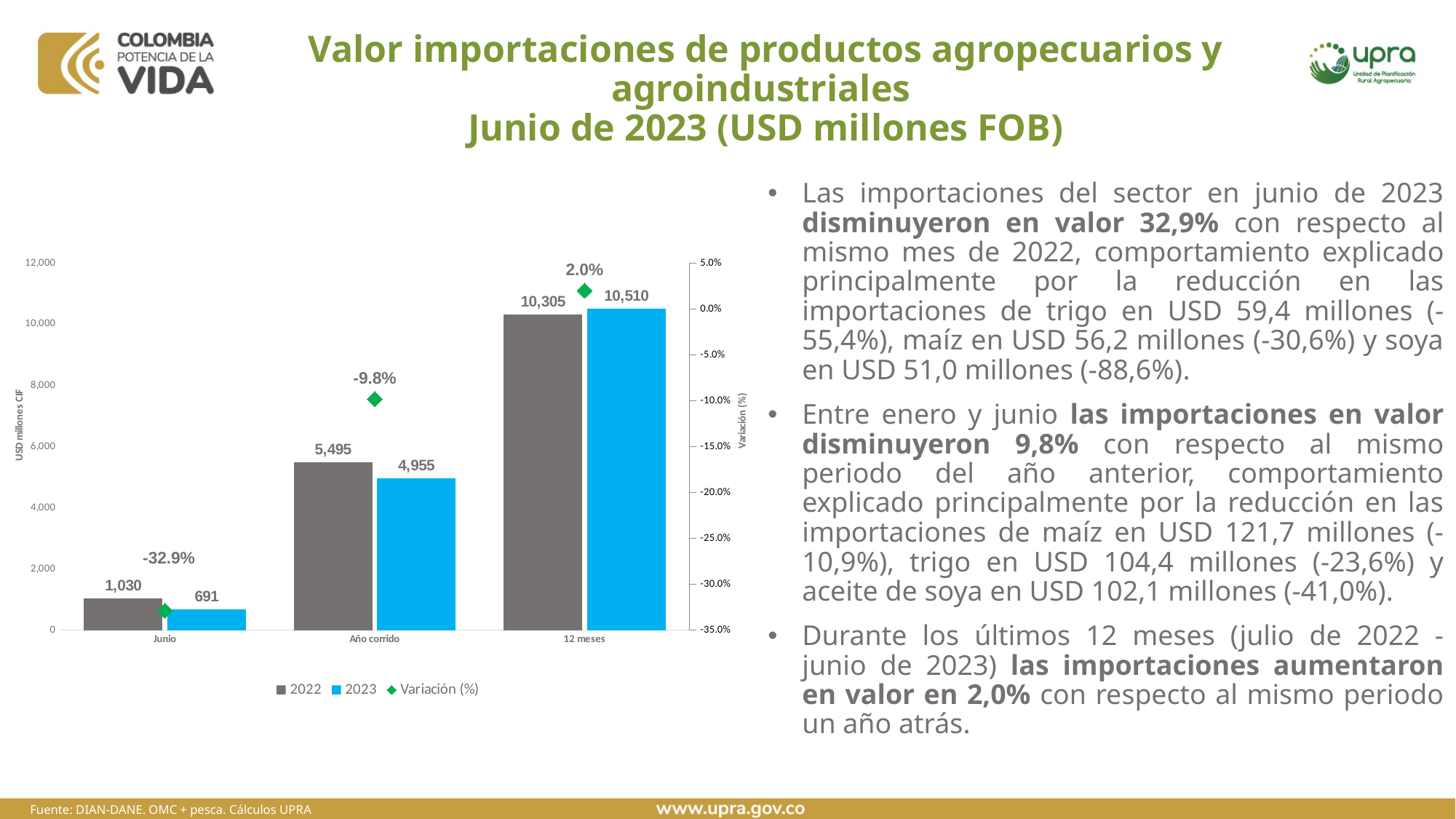
Which category has the highest 2023 value? 12 meses What is the 2023 value for Año corrido? 4,955 What is the difference between the 2022 and 2023 values for Año corrido? 540 What is the label of the left vertical axis? USD millones CIF Which is larger for 12 meses, the 2022 value or the 2023 value? 2023 What kind of chart is used for the 2022 and 2023 series? Bar chart What is the Variación (%) for 12 meses? 2.0% How many series does the legend list? 3 What is the 2022 value for Junio? 1,030 How many categories are shown on the x axis? 3 Which category has the lowest 2022 value? Junio What is the Variación (%) for Junio? -32.9%